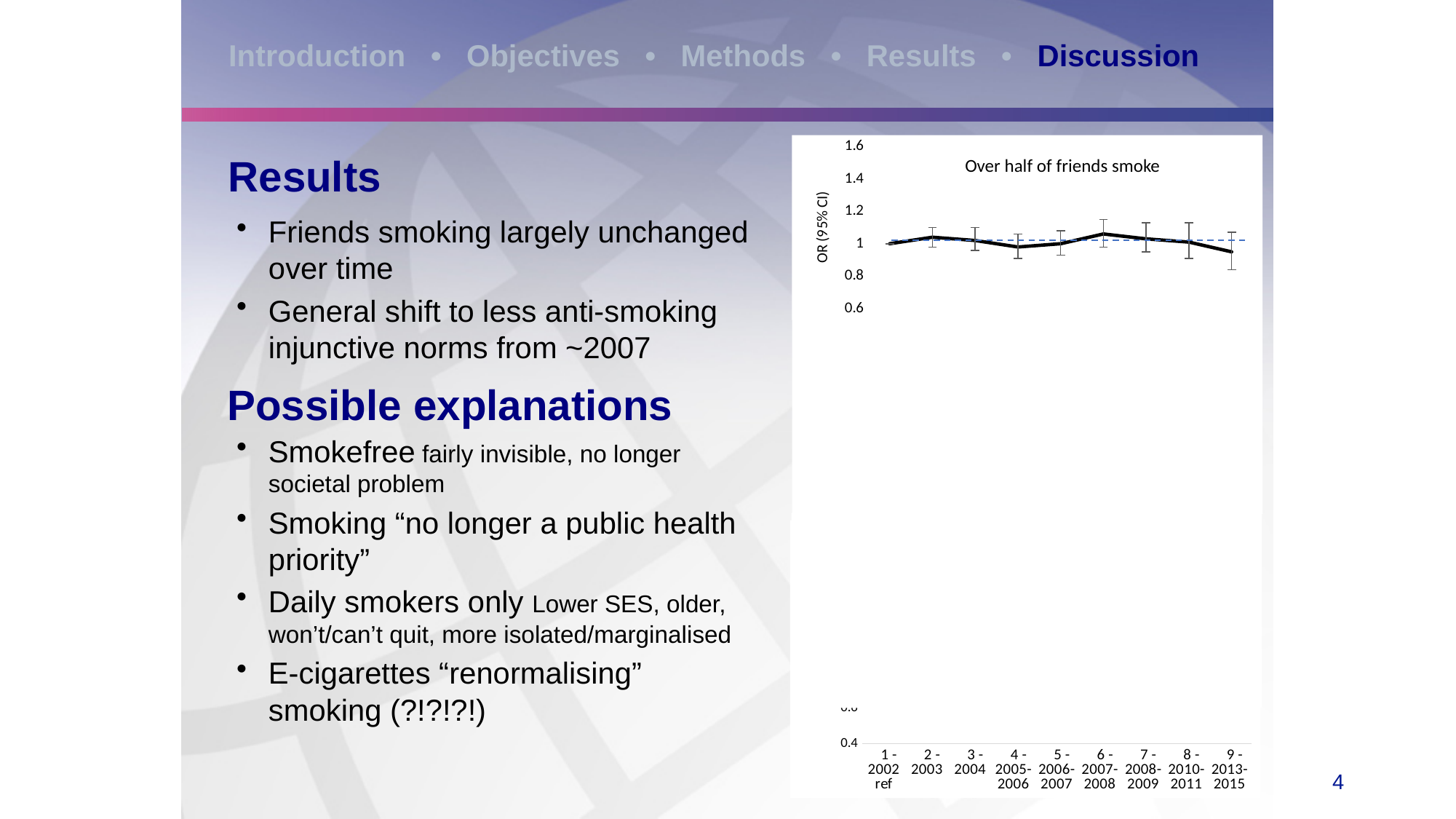
What is the highest value shown on the vertical axis of the chart? 1.6 Is the value for 9 - 2013-2015 greater or less than 1? less Which time point has the highest odds ratio on the chart? 6 - 2007-2008 Which x-axis category is labelled as the reference category? 1 - 2002 ref Do the odds ratios show a strong rising trend, a strong falling trend, or stay roughly flat across the time points? roughly flat What is the title of the chart? Over half of friends smoke Is the value for 4 - 2005-2006 greater or less than 1.2? less Is the value for 2 - 2003 greater or less than 0.8? greater What is the label on the vertical axis of the chart? OR (95% CI) What type of chart is shown on the slide? line chart How many time points are plotted along the x axis of the chart? 9